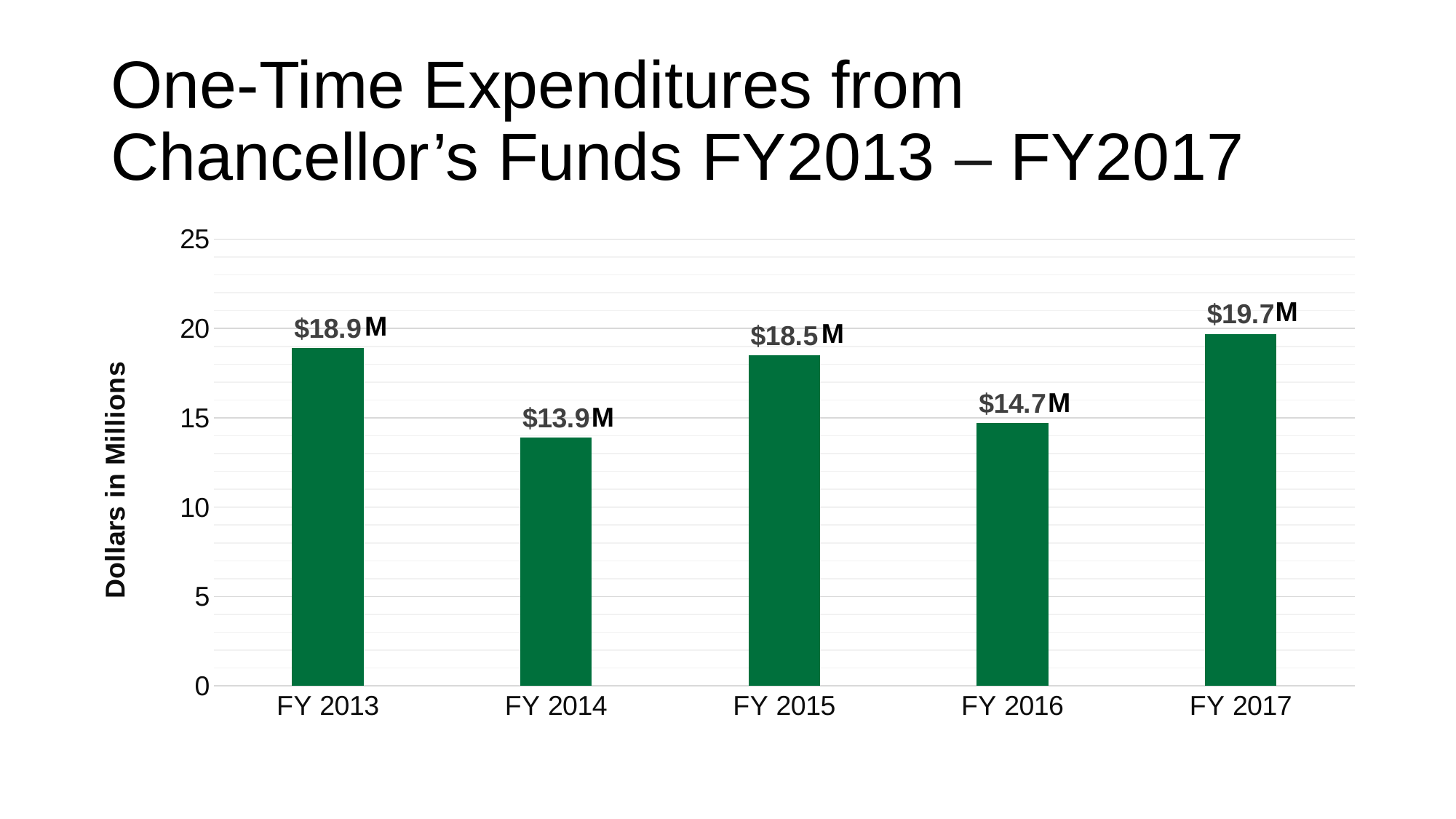
Is the value for FY 2016 greater or less than 15? less What kind of chart is shown on the slide? bar chart What is the label of the vertical axis? Dollars in Millions What is the value for FY 2014? $13.9M Which is larger, the value for FY 2013 or the value for FY 2016? FY 2013 Which fiscal year has the lowest one-time expenditure? FY 2014 What is the value for FY 2015? $18.5M What is the difference between the FY 2013 and FY 2016 values? $4.2M How many fiscal years are shown on the chart? 5 Which fiscal year has the highest one-time expenditure? FY 2017 What is the value for FY 2017? $19.7M What is the difference between the FY 2017 and FY 2014 values? $5.8M